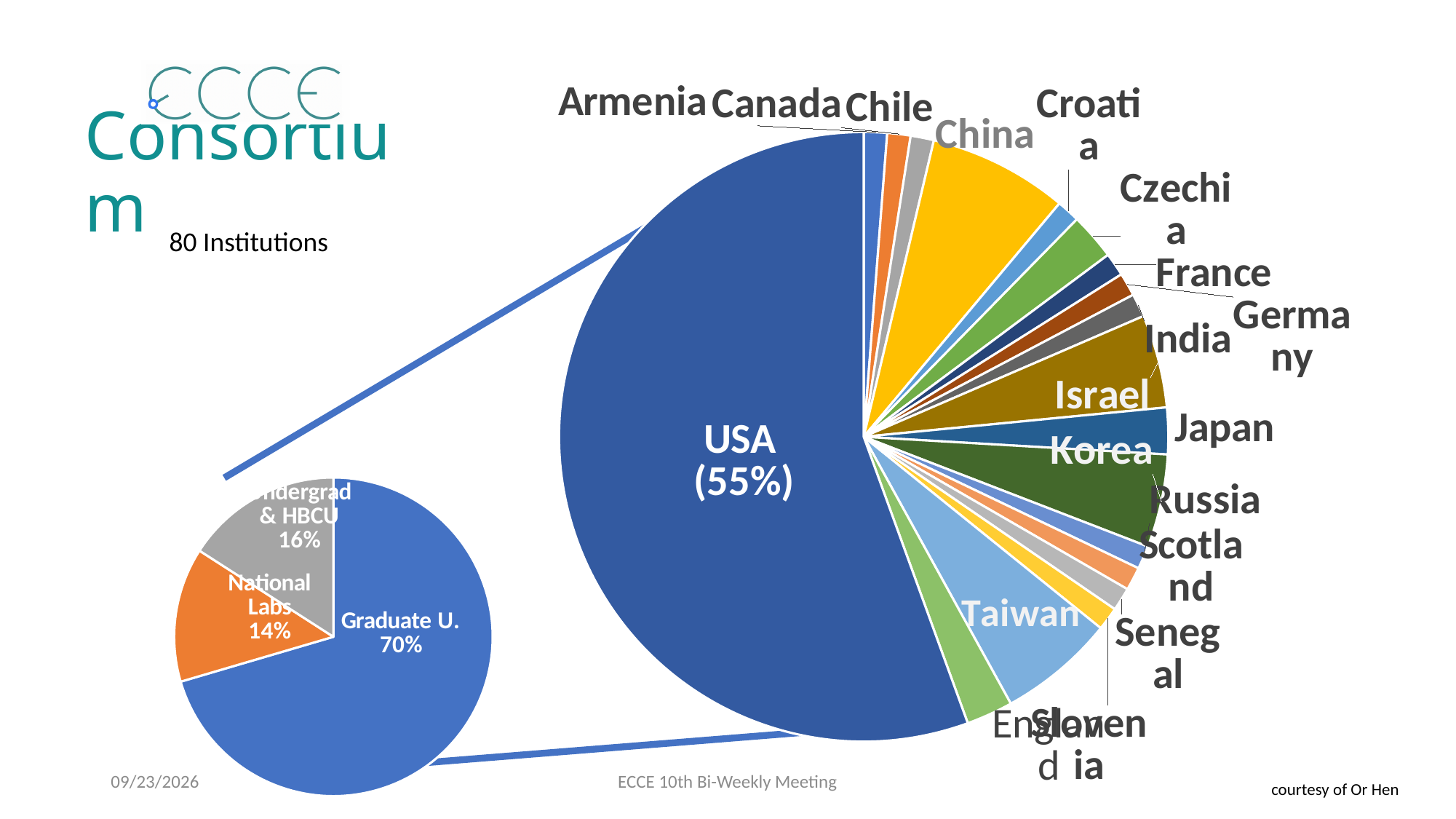
In the small pie chart at the bottom left, what is the difference in percentage points between Graduate U. and National Labs? 56 In the large pie chart of countries, what share is shown for USA? 55% In the small pie chart at the bottom left, what share is shown for National Labs? 14% In the small pie chart at the bottom left, what share is shown for Graduate U.? 70% In the small pie chart at the bottom left, how many categories are there? 3 According to the text next to the title, how many institutions are in the consortium? 80 Institutions In the small pie chart at the bottom left, what share is shown for Undergrad & HBCU? 16% In the small pie chart at the bottom left, which category has the smallest share? National Labs In the large pie chart of countries, which slice is larger, USA or Taiwan? USA What kind of chart is the large chart showing countries? Pie chart In the large pie chart of countries, which slice is larger, Israel or Armenia? Israel In the large pie chart of countries, which country has the largest slice? USA